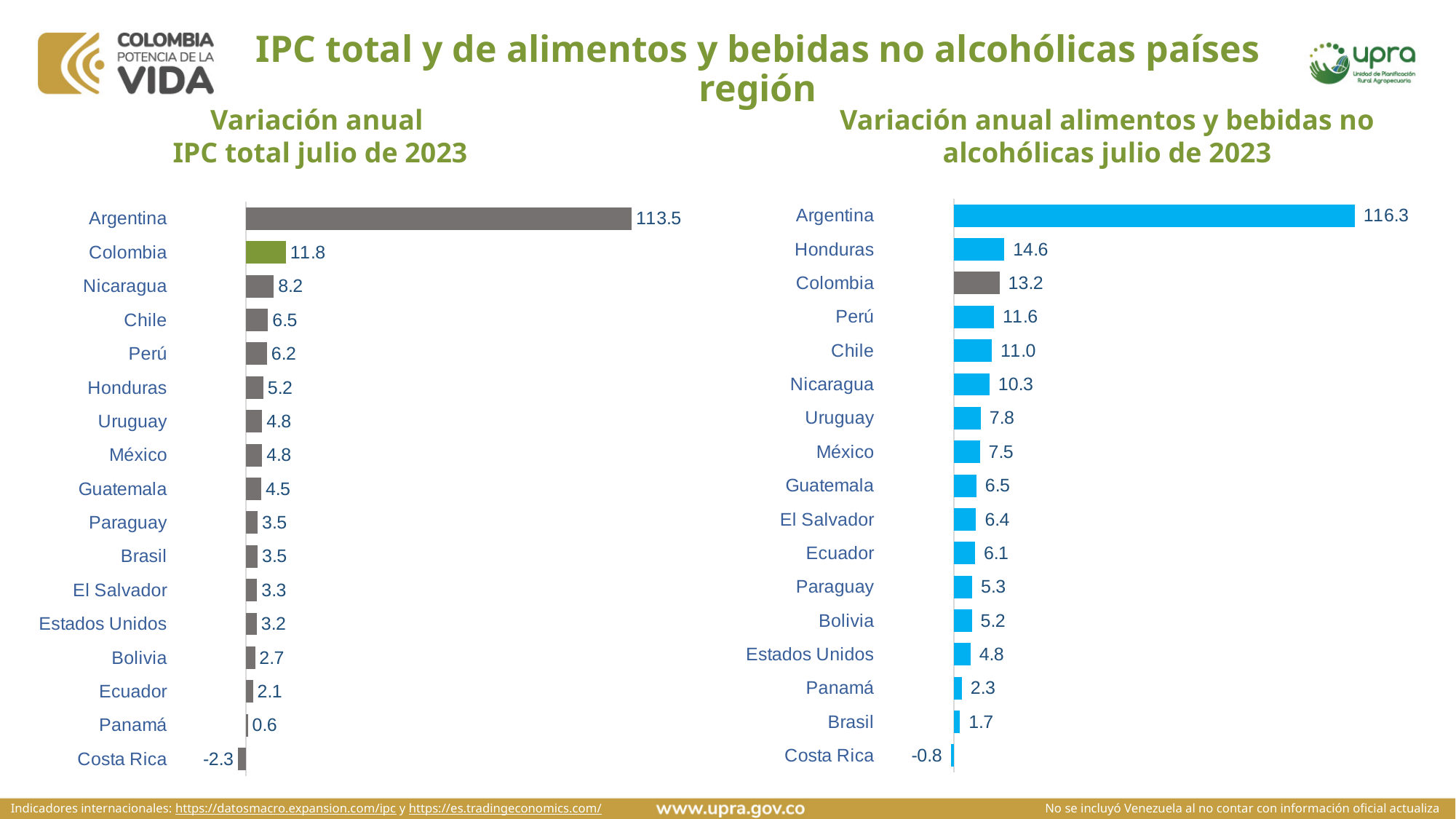
What kind of chart is the right chart (Variación anual alimentos y bebidas no alcohólicas julio de 2023)? Bar chart In the right chart (Variación anual alimentos y bebidas no alcohólicas julio de 2023), which is larger, the value for Brasil or the value for Panamá? Panamá How many countries are shown in the left chart (Variación anual IPC total julio de 2023)? 17 In the left chart (Variación anual IPC total julio de 2023), what is the difference between the values for Argentina and Colombia? 101.7 In the left chart (Variación anual IPC total julio de 2023), which country has the highest value? Argentina In the left chart (Variación anual IPC total julio de 2023), which is larger, the value for Nicaragua or the value for Chile? Nicaragua In the right chart (Variación anual alimentos y bebidas no alcohólicas julio de 2023), what is the difference between the values for Colombia and Perú? 1.6 In the right chart (Variación anual alimentos y bebidas no alcohólicas julio de 2023), which country has the lowest value? Costa Rica In the left chart (Variación anual IPC total julio de 2023), what is the value for Colombia? 11.8 In the right chart (Variación anual alimentos y bebidas no alcohólicas julio de 2023), which country's bar is coloured grey instead of blue? Colombia In the left chart (Variación anual IPC total julio de 2023), what is the value for Costa Rica? -2.3 In the right chart (Variación anual alimentos y bebidas no alcohólicas julio de 2023), what is the value for Honduras? 14.6